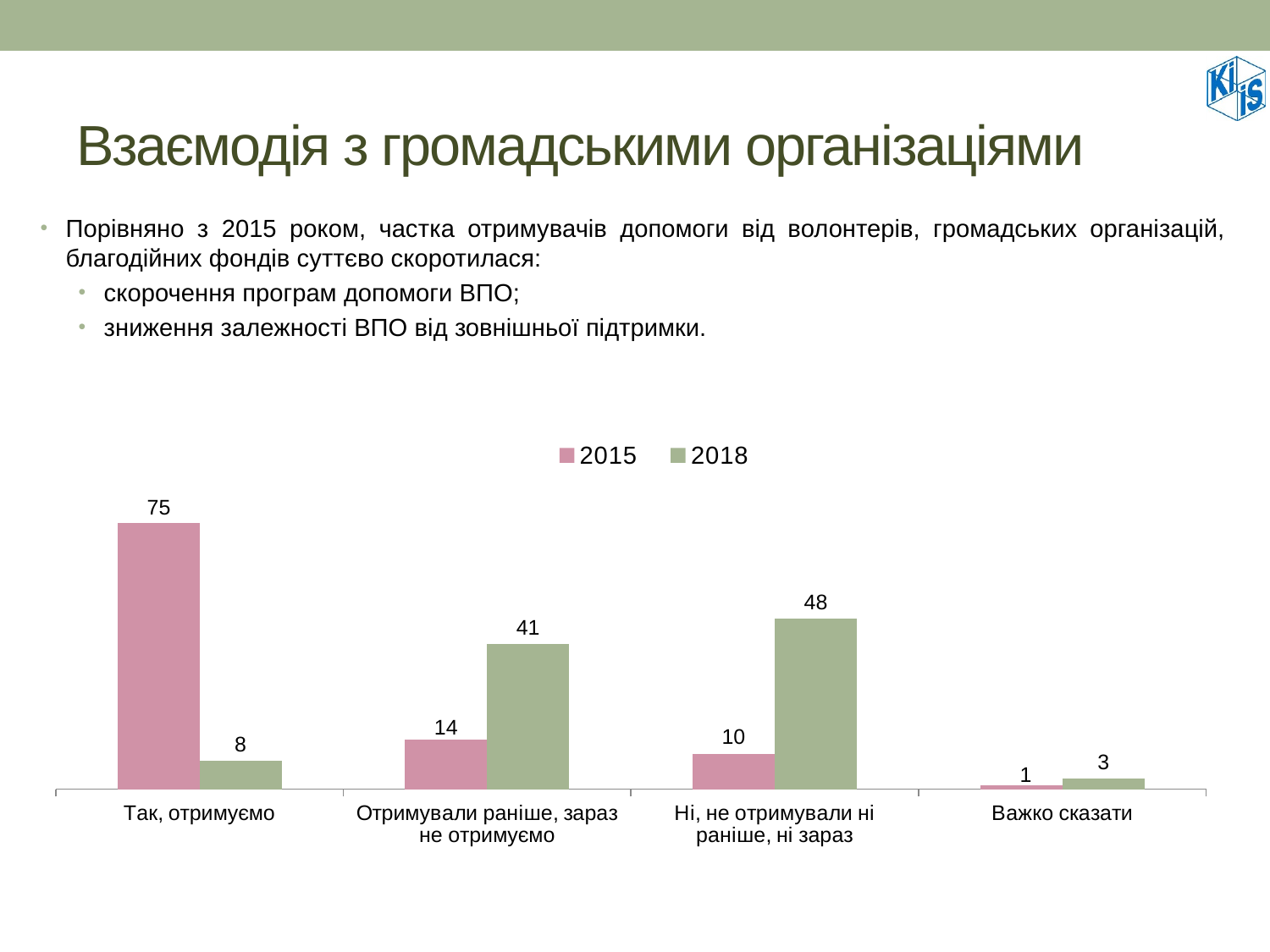
What is the 2015 value for "Важко сказати"? 1 What is the 2018 value for "Ні, не отримували ні раніше, ні зараз"? 48 What is the difference between the 2015 and 2018 values for "Так, отримуємо"? 67 Which category has the highest 2018 value? Ні, не отримували ні раніше, ні зараз What is the 2015 value for "Так, отримуємо"? 75 How many categories are shown on the x axis? 4 What type of chart is shown on the slide? Bar chart How many series does the legend list? 2 Which series is shown in green in the legend? 2018 What is the 2018 value for "Отримували раніше, зараз не отримуємо"? 41 Which category has the lowest 2015 value? Важко сказати Which is larger for "Ні, не отримували ні раніше, ні зараз": the 2015 value or the 2018 value? 2018